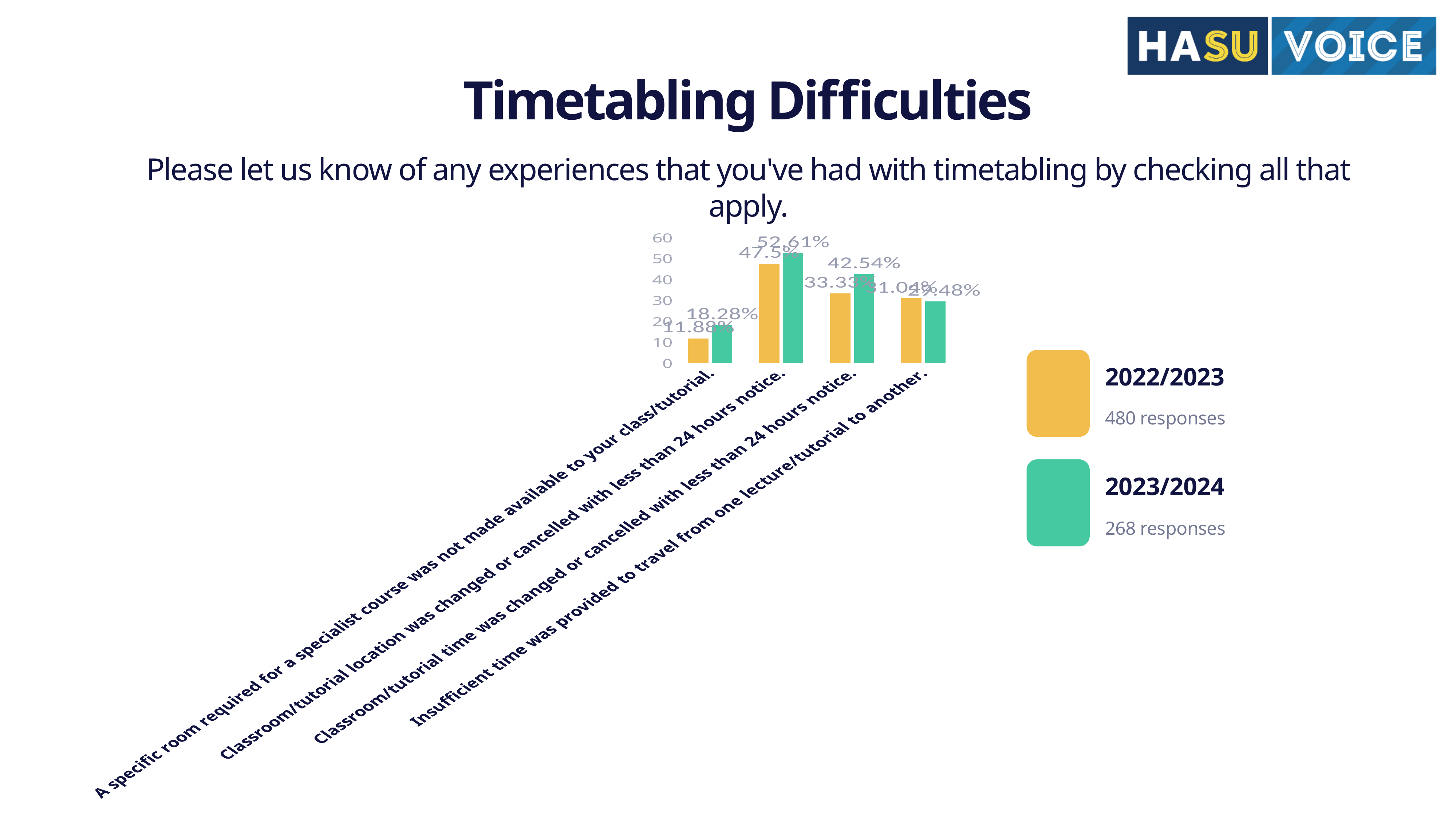
Which category has the highest 2023/2024 value? Classroom/tutorial location was changed or cancelled with less than 24 hours notice. Is the 2023/2024 value for 'Classroom/tutorial location was changed or cancelled with less than 24 hours notice.' greater or less than 50? greater What is the 2023/2024 value for 'Classroom/tutorial time was changed or cancelled with less than 24 hours notice.'? 42.54% What is the 2022/2023 value for 'A specific room required for a specialist course was not made available to your class/tutorial.'? 11.88% How many responses does the legend give for 2022/2023? 480 responses What is the 2023/2024 value for 'Classroom/tutorial location was changed or cancelled with less than 24 hours notice.'? 52.61% How many series does the legend list? 2 What is the difference between the 2023/2024 and 2022/2023 values for 'Classroom/tutorial time was changed or cancelled with less than 24 hours notice.'? 9.21 percentage points How many categories are plotted on the x axis? 4 What kind of chart is shown on the slide? bar chart Which category has the lowest 2022/2023 value? A specific room required for a specialist course was not made available to your class/tutorial. What is the 2022/2023 value for 'Classroom/tutorial time was changed or cancelled with less than 24 hours notice.'? 33.33%